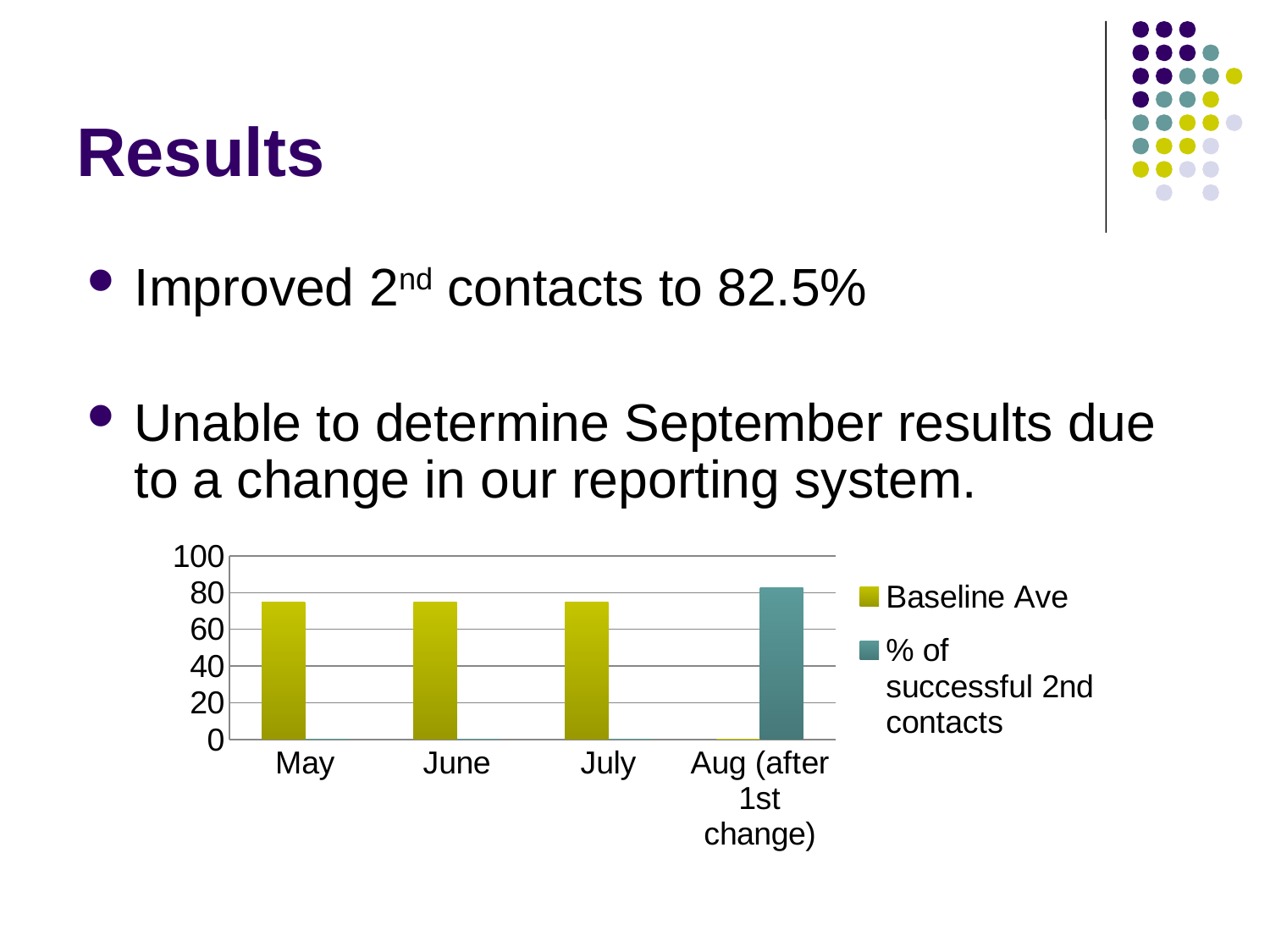
Is the value for June greater or less than 80? less Is the value for July greater or less than 40? greater Which is larger, the bar for May or the bar for Aug (after 1st change)? Aug (after 1st change) Is the value for May greater or less than 60? greater What is the highest value shown on the chart's vertical axis? 100 How many categories are shown on the x axis of the chart? 4 How many series does the chart's legend list? 2 What kind of chart is shown on the slide? bar chart What is the name of the first series listed in the chart's legend? Baseline Ave Which series does the bar for Aug (after 1st change) belong to, according to the legend? % of successful 2nd contacts Which category has the highest bar in the chart? Aug (after 1st change)